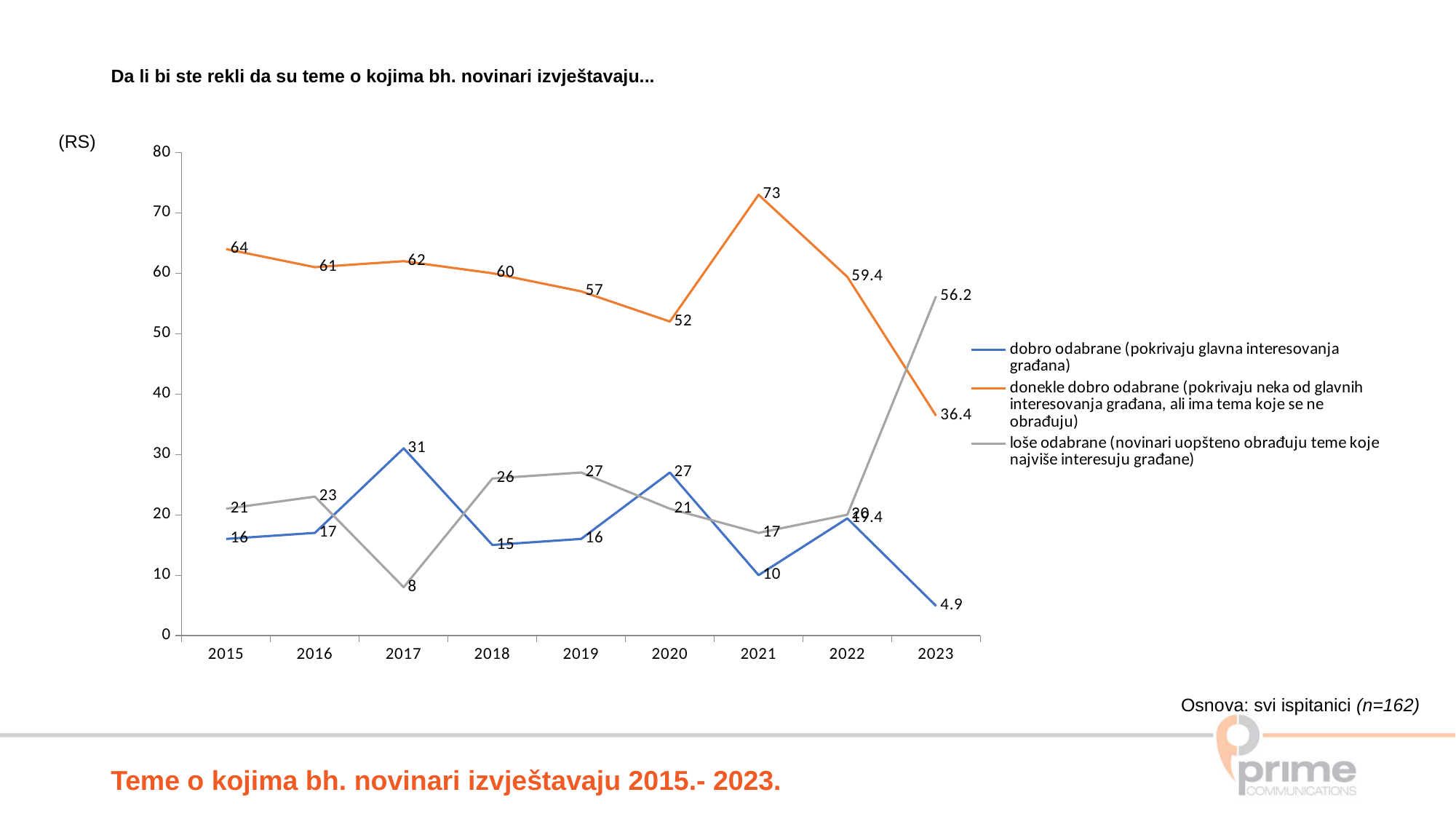
How many years are shown on the x axis? 9 In 2023, which series has the higher value: 'loše odabrane' or 'donekle dobro odabrane'? loše odabrane What type of chart is shown on the slide? line chart In which year does the 'dobro odabrane' series reach its lowest value? 2023 What colour is the line for the 'dobro odabrane' series? blue What is the value of the 'donekle dobro odabrane' series in 2021? 73 What is the value of the 'loše odabrane' series in 2017? 8 In which year does the 'donekle dobro odabrane' series reach its highest value? 2021 What is the difference between the 'loše odabrane' value in 2023 and in 2022? 36.2 How many series does the legend list? 3 Does the 'donekle dobro odabrane' series rise or fall from 2021 to 2023? fall What is the value of the 'dobro odabrane' series in 2023? 4.9